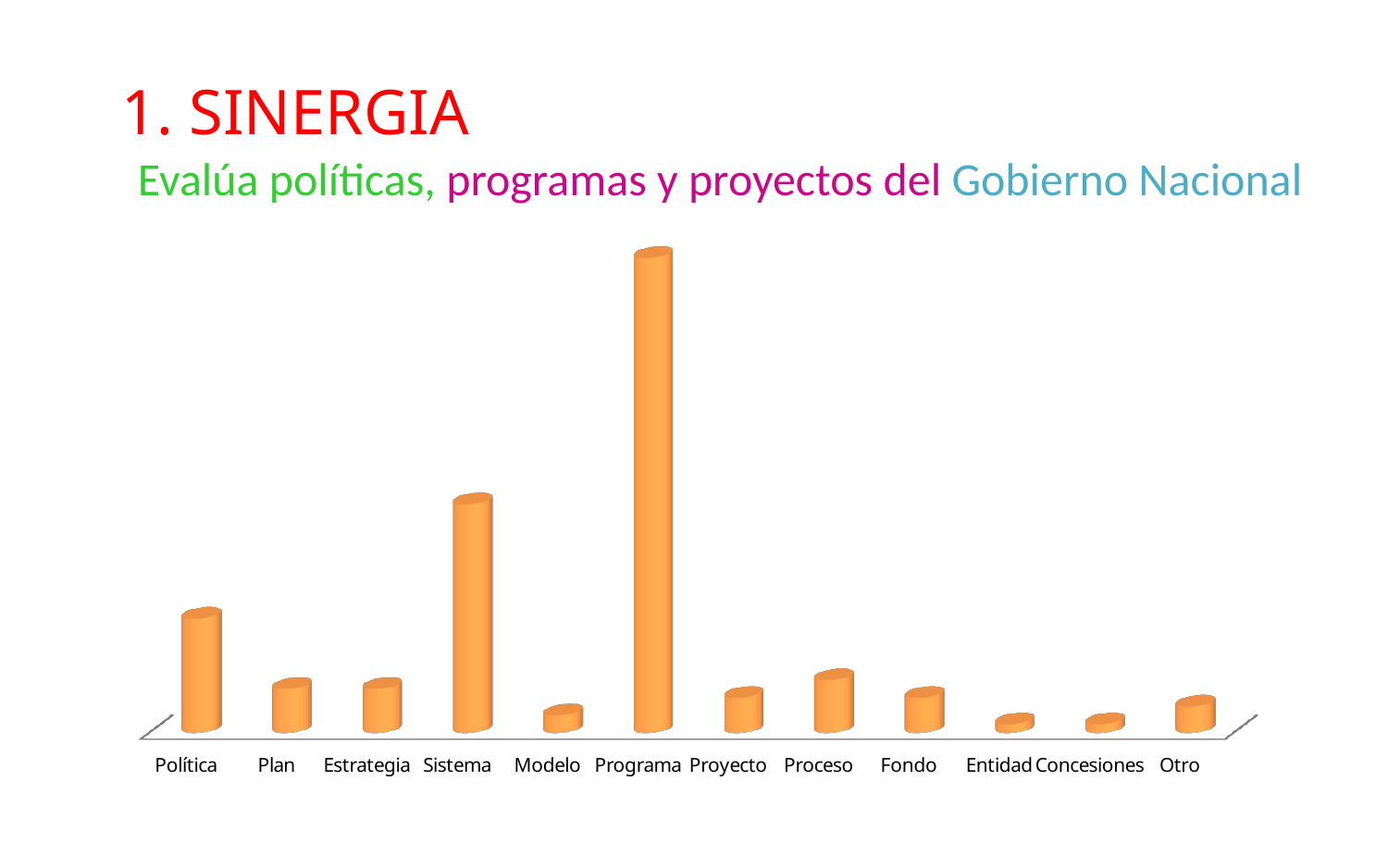
Which category has the highest bar in the chart? Programa How many categories are shown on the x axis of the chart? 12 Which bar is taller, Fondo or Entidad? Fondo What kind of chart is shown on the slide? bar chart Which bar is taller, Otro or Modelo? Otro Which bar is taller, Proceso or Proyecto? Proceso Which category has the second highest bar in the chart? Sistema What colour are the bars in the chart? orange What is the label of the first category on the x axis of the chart? Política